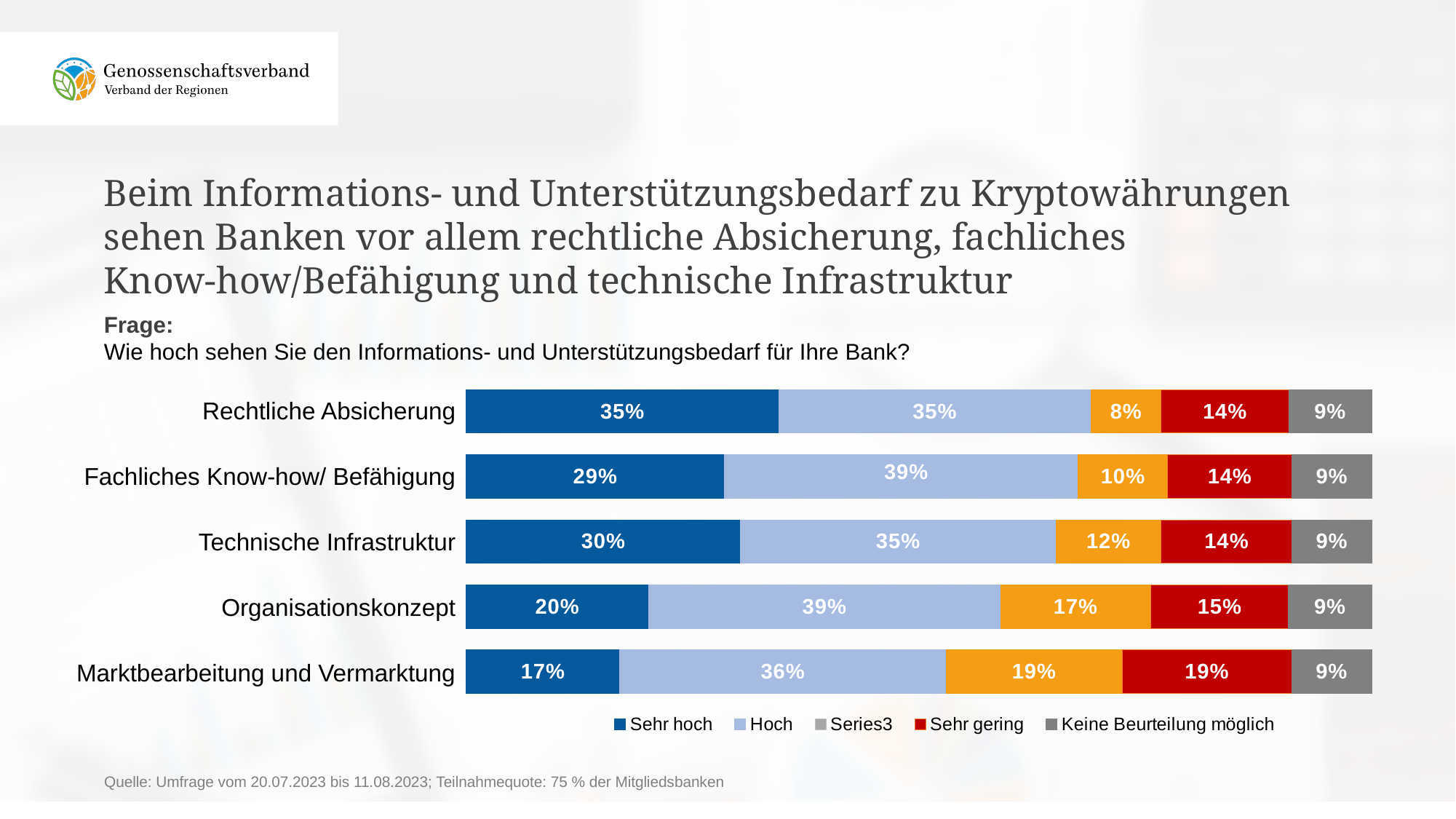
What kind of chart is shown on the slide? Stacked bar chart What is the "Sehr gering" value for Marktbearbeitung und Vermarktung? 19% Which category has the highest "Sehr hoch" share? Rechtliche Absicherung What is the "Hoch" value for Organisationskonzept? 39% Which has the larger "Hoch" value: Fachliches Know-how/ Befähigung or Technische Infrastruktur? Fachliches Know-how/ Befähigung Which category has the lowest "Sehr hoch" share? Marktbearbeitung und Vermarktung What percentage of banks rated the need for Rechtliche Absicherung as "Sehr hoch"? 35% How many series does the legend list? 5 What is the "Keine Beurteilung möglich" value for Technische Infrastruktur? 9% How many percentage points higher is the "Sehr hoch" value for Rechtliche Absicherung than for Organisationskonzept? 15 percentage points What is the third entry in the chart legend? Series3 How many categories are shown in the chart? 5